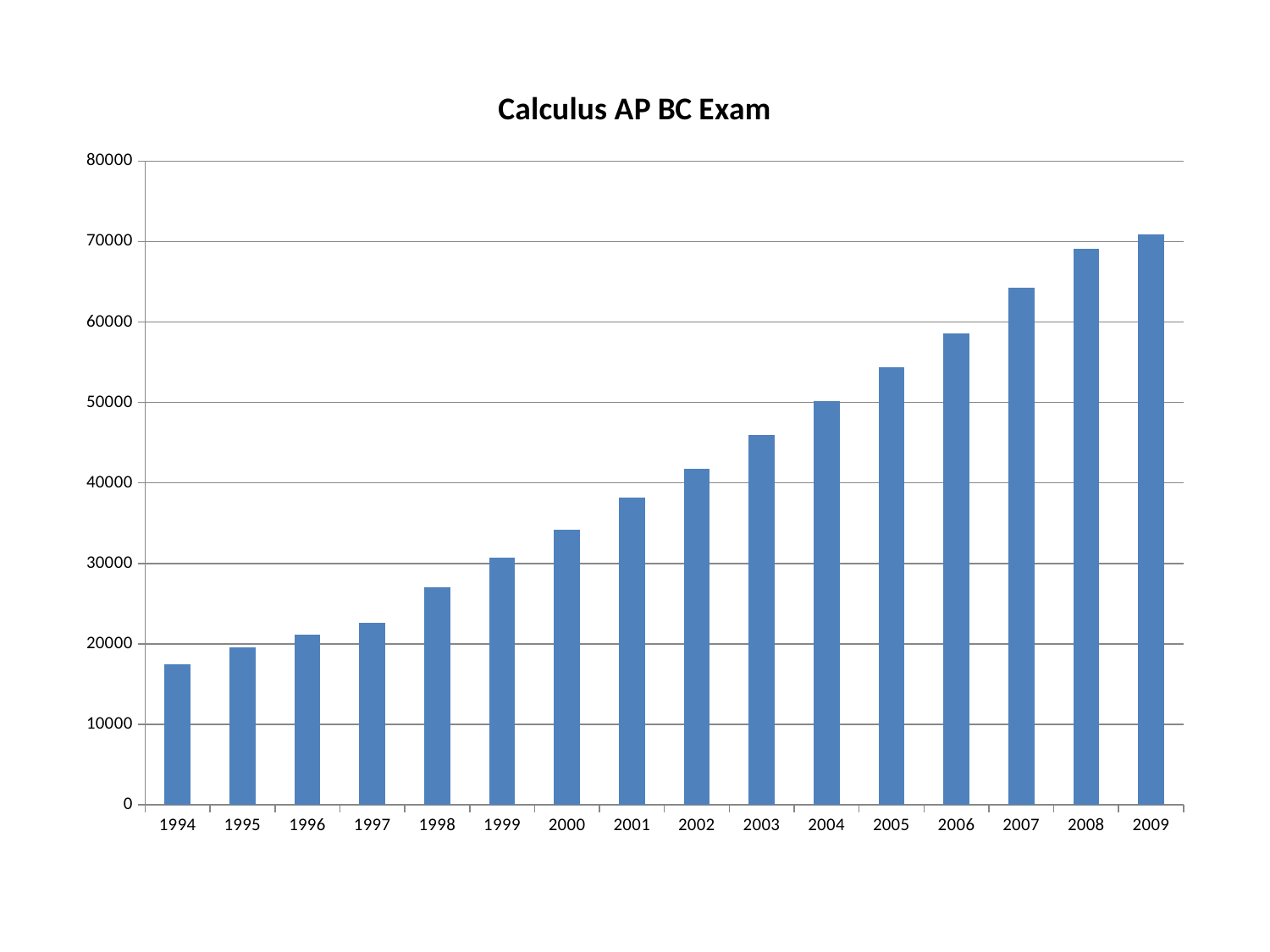
Which year has the highest value in the chart? 2009 Which year has the lowest value in the chart? 1994 How many years are shown on the x axis of the chart? 16 Is the value for 1994 greater or less than 20000? less Is the value for 1998 greater or less than 30000? less Is the value for 2003 greater or less than 40000? greater What kind of chart is shown on the slide? bar chart Which is larger, the value for 2001 or the value for 2005? 2005 What is the title of the chart? Calculus AP BC Exam Do the values rise or fall from 1994 to 2009? rise